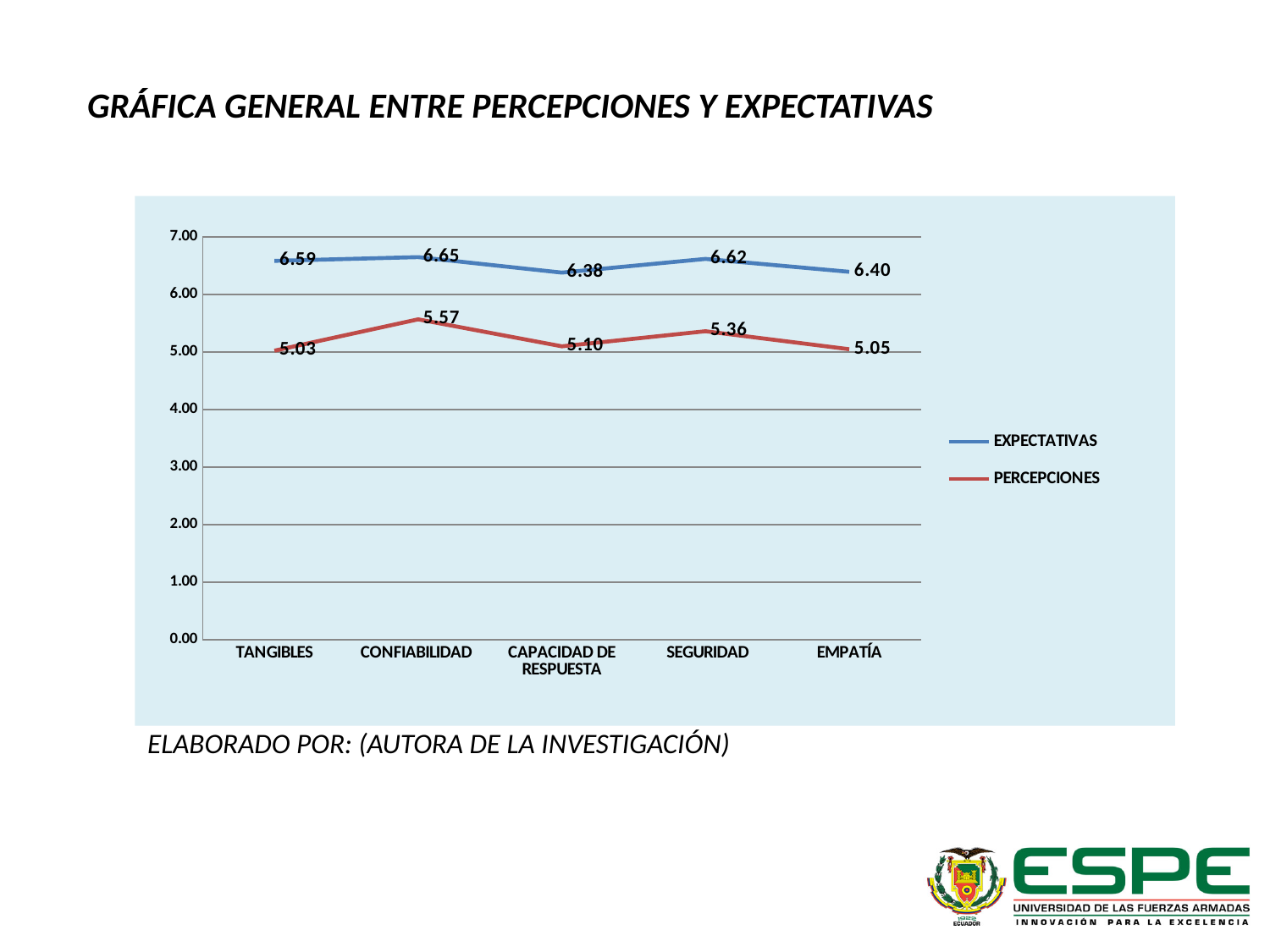
What is the EXPECTATIVAS value for CONFIABILIDAD? 6.65 What is the EXPECTATIVAS value for EMPATÍA? 6.40 What kind of chart is shown on the slide? line chart What is the PERCEPCIONES value for SEGURIDAD? 5.36 Which category has the highest PERCEPCIONES value? CONFIABILIDAD How many series does the legend list? 2 Is the PERCEPCIONES value for EMPATÍA greater or less than 6.00? less What is the difference between EXPECTATIVAS and PERCEPCIONES for TANGIBLES? 1.56 Which is larger: the PERCEPCIONES value for CAPACIDAD DE RESPUESTA or for SEGURIDAD? SEGURIDAD Which colour is used for the PERCEPCIONES line? red How many categories are shown on the x axis? 5 Which category has the lowest EXPECTATIVAS value? CAPACIDAD DE RESPUESTA